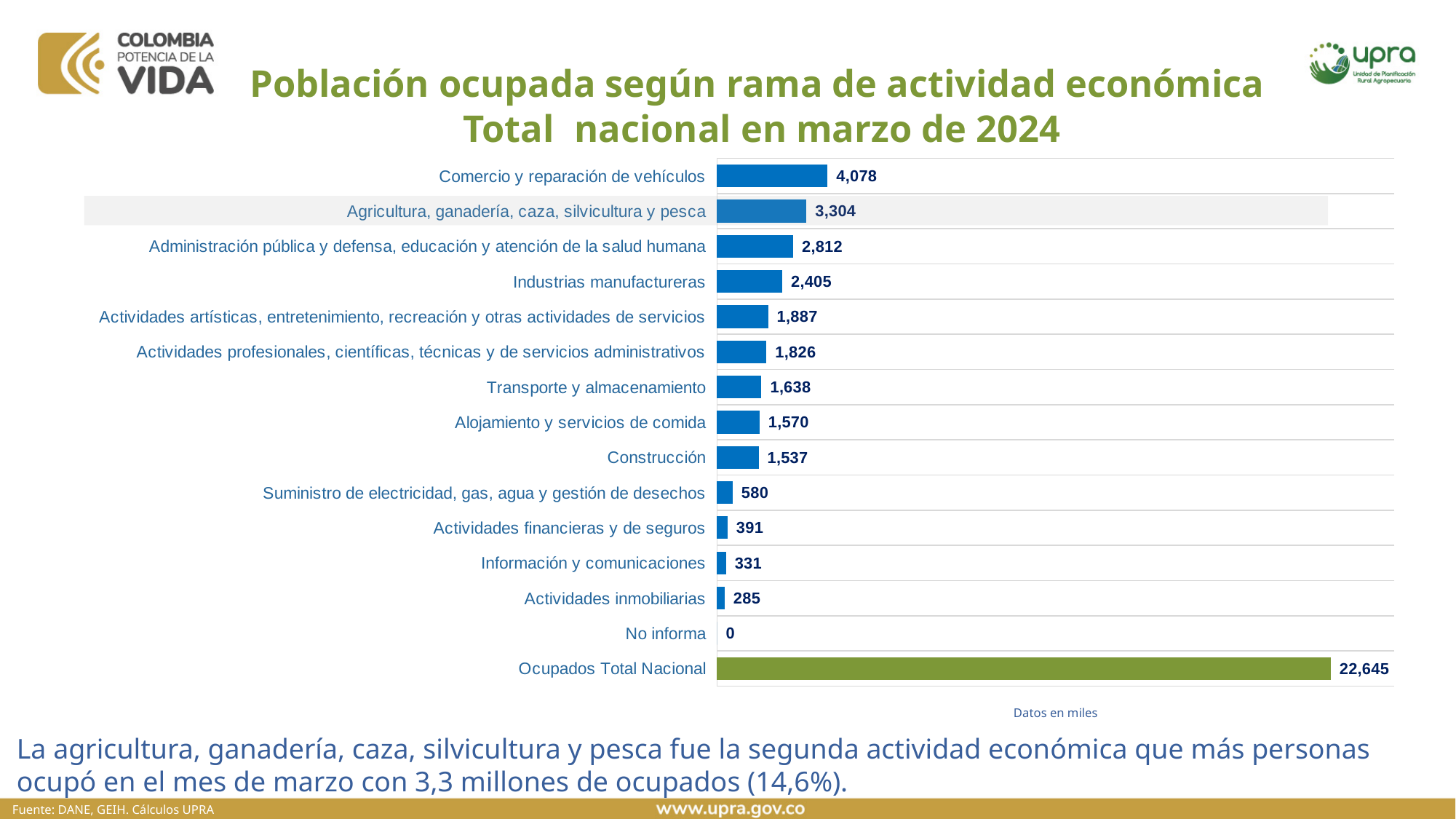
What is the value for Agricultura, ganadería, caza, silvicultura y pesca? 3,304 Which is larger, Transporte y almacenamiento or Alojamiento y servicios de comida? Transporte y almacenamiento What is the value shown for Ocupados Total Nacional? 22,645 What is the difference between Comercio y reparación de vehículos and Agricultura, ganadería, caza, silvicultura y pesca? 774 What kind of chart is shown on the slide? Bar chart What is the value for Actividades inmobiliarias? 285 What is the value for Construcción? 1,537 How many categories are shown in the chart? 15 Which category has the lowest value in the chart? No informa What is the value for Comercio y reparación de vehículos? 4,078 What is the difference between Industrias manufactureras and Construcción? 868 Which category has the highest value in the chart? Ocupados Total Nacional